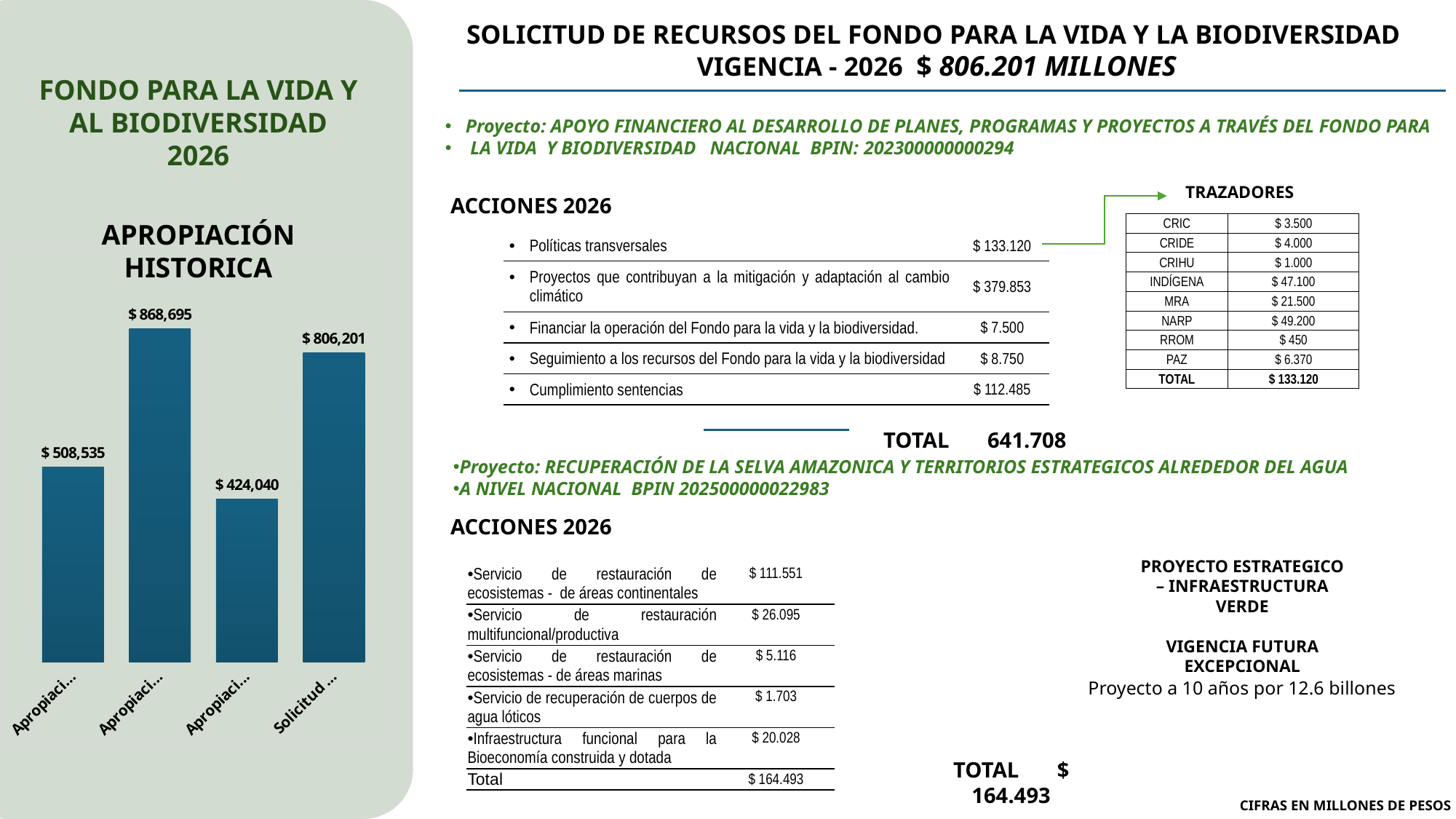
How many bars does the APROPIACIÓN HISTORICA chart show? 4 What kind of chart is shown under the heading APROPIACIÓN HISTORICA? bar chart In the APROPIACIÓN HISTORICA chart, what is the value of the first (leftmost) bar? $ 508,535 In the APROPIACIÓN HISTORICA chart, what is the difference between the second bar and the first bar? $ 360,160 In the APROPIACIÓN HISTORICA chart, which is larger: the first bar or the last bar ('Solicitud ...')? the last bar ($ 806,201) In the APROPIACIÓN HISTORICA chart, what is the value of the last bar, labelled 'Solicitud ...'? $ 806,201 What is the title of the bar chart on the left side of the slide? APROPIACIÓN HISTORICA In the APROPIACIÓN HISTORICA chart, does the value rise or fall from the third bar to the fourth bar? rise In the APROPIACIÓN HISTORICA chart, what is the value of the third bar? $ 424,040 In the APROPIACIÓN HISTORICA chart, how much larger is the fourth bar than the third bar? $ 382,161 What is the lowest value shown in the APROPIACIÓN HISTORICA chart? $ 424,040 What is the highest value shown in the APROPIACIÓN HISTORICA chart? $ 868,695